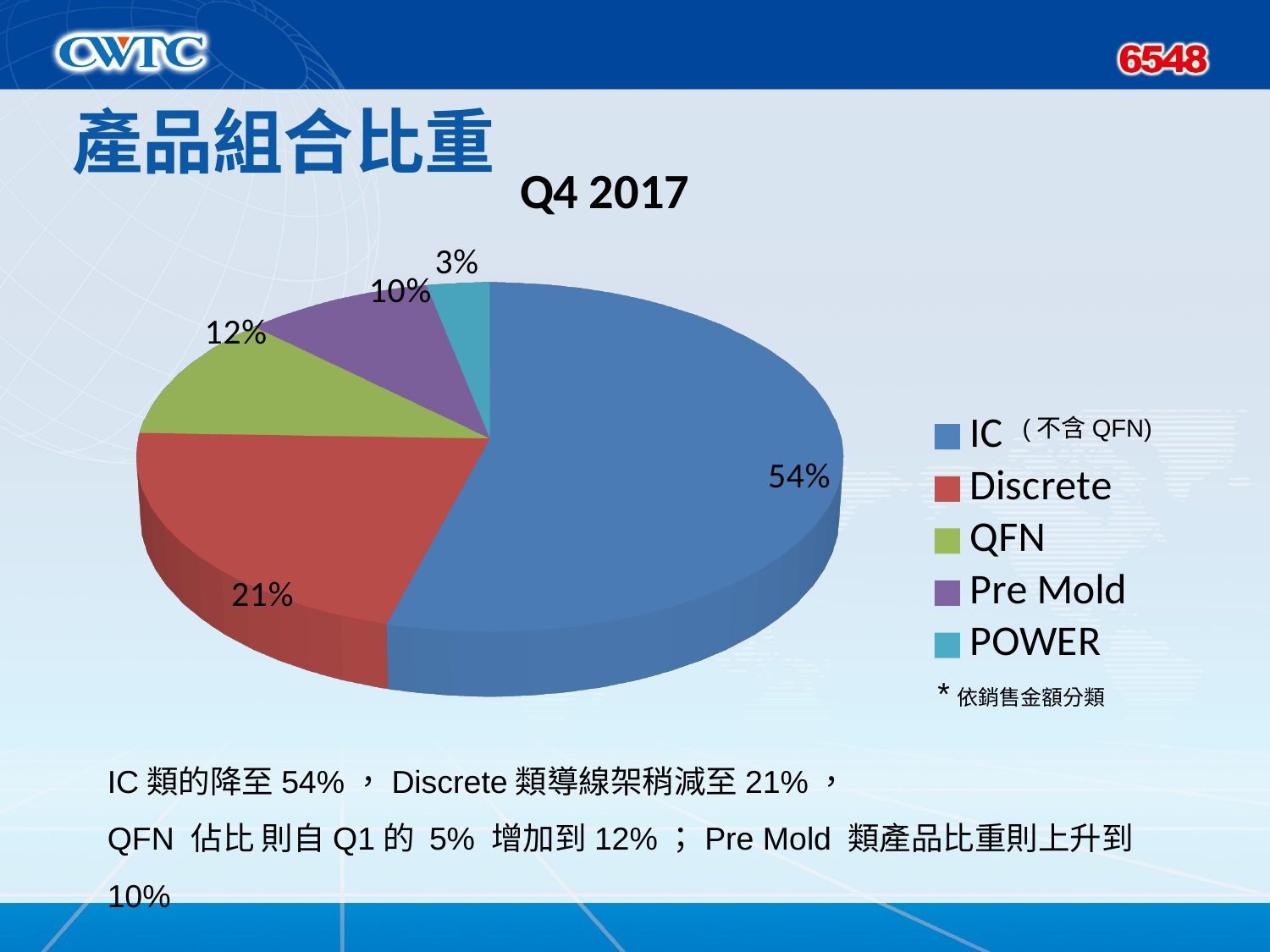
What is the difference between the Discrete share and the QFN share? 9% What is the value shown for Pre Mold? 10% Which category has the smallest share of the pie? POWER What is the value shown for POWER? 3% What is the value shown for QFN? 12% Which category has the largest share of the pie? IC (不含 QFN) What share of the pie does IC (不含 QFN) hold? 54% What is the value shown for Discrete? 21% How many categories are shown in the pie chart? 5 What kind of chart is shown on the slide? Pie chart What is the title shown above the pie chart? Q4 2017 Which is larger, the share for QFN or the share for Pre Mold? QFN